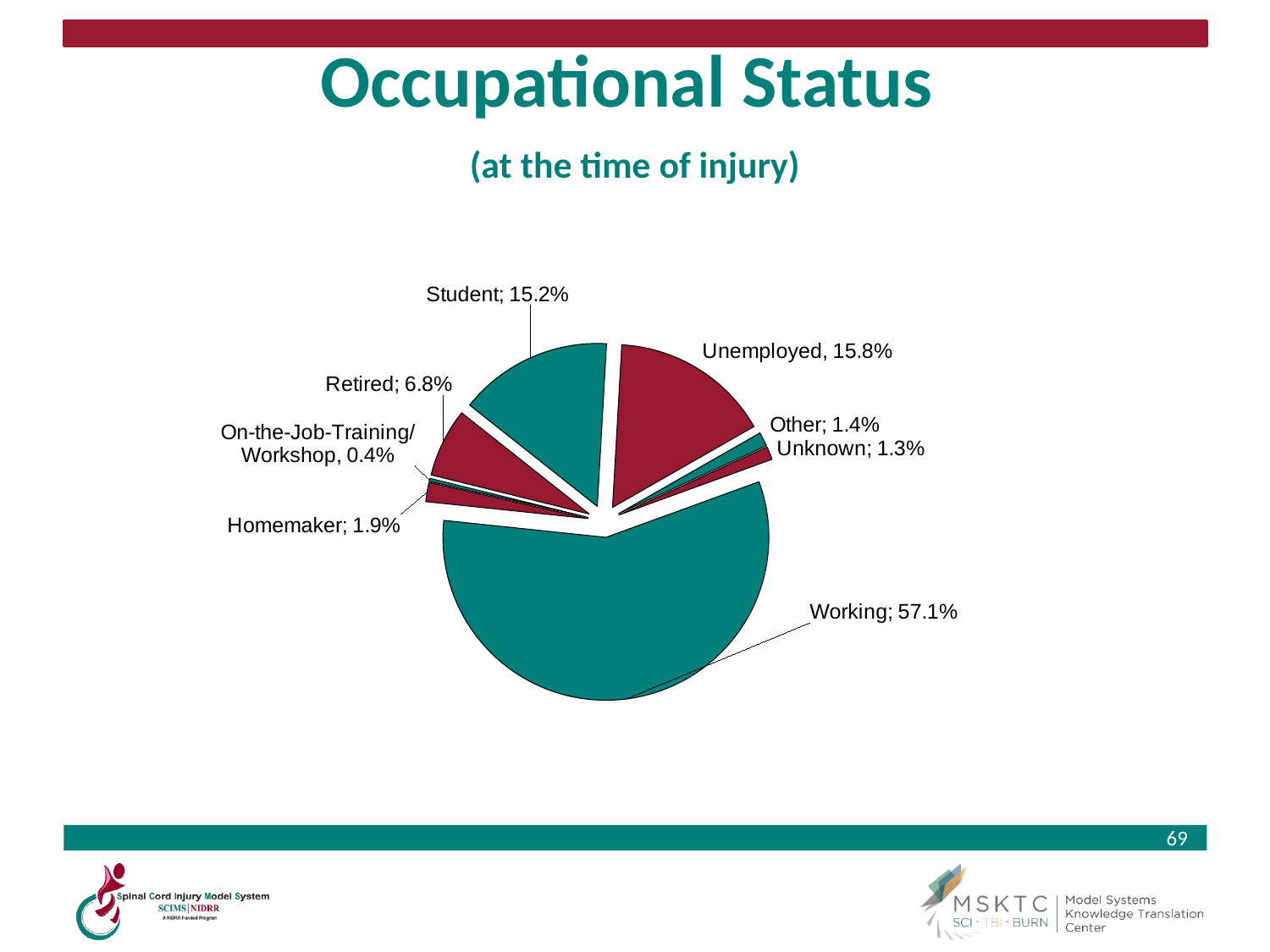
How many categories are shown in the pie chart? 8 Which category has the largest slice of the pie? Working What percentage is shown for Unemployed? 15.8% Which is larger, the Homemaker slice or the Other slice? Homemaker What percentage is shown for Retired? 6.8% What share of the pie is labelled Working? 57.1% What is the difference between the Unemployed and Student percentages? 0.6% What value is printed for On-the-Job-Training/Workshop? 0.4% Which category has the smallest slice of the pie? On-the-Job-Training/Workshop What value is printed for the Student slice? 15.2% What is the title of the chart on the slide? Occupational Status (at the time of injury) What kind of chart is shown on the slide? Pie chart